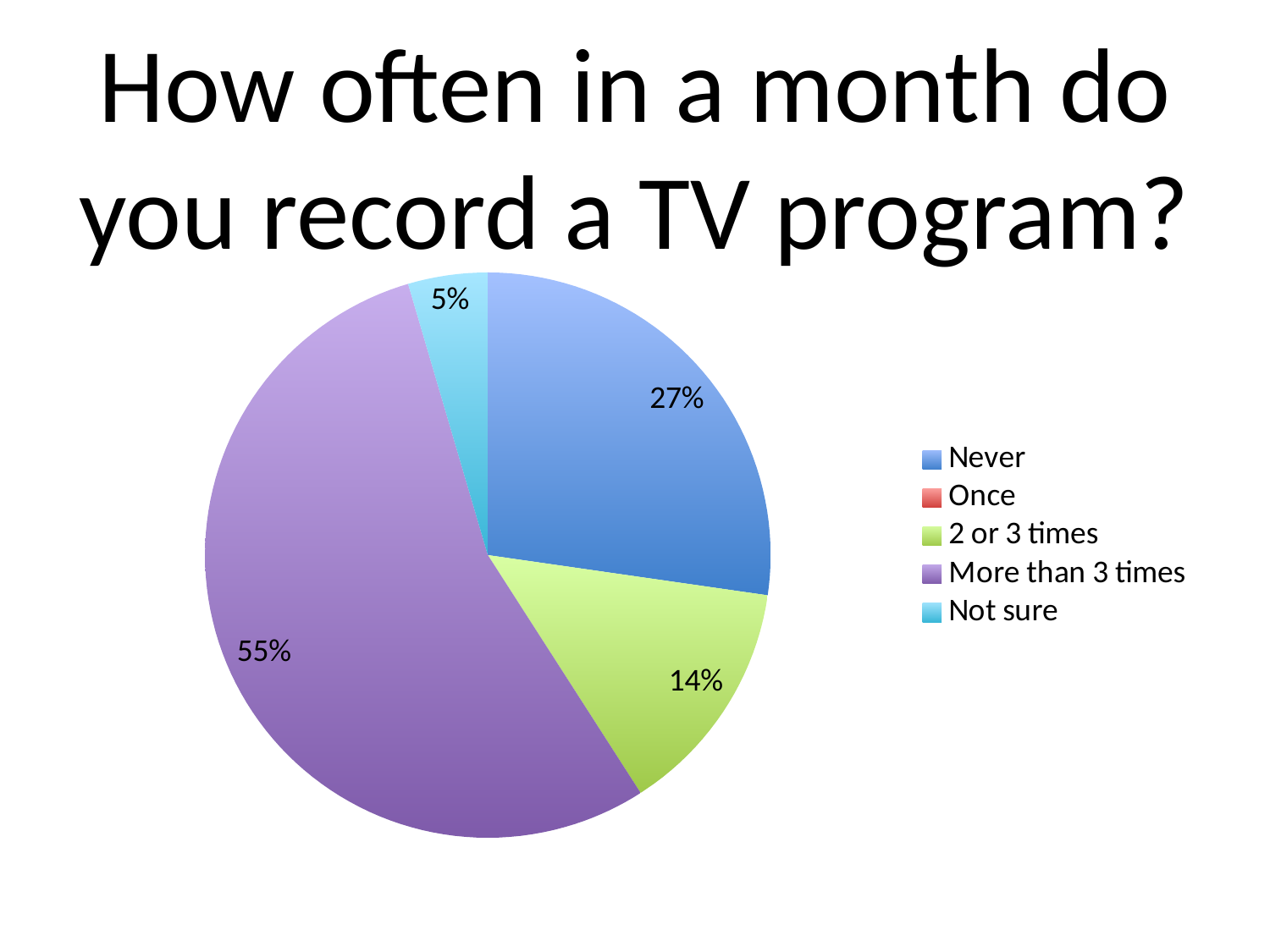
How many percentage points larger is "Never" than "2 or 3 times"? 13 How many percentage points larger is "More than 3 times" than "Never"? 28 What percentage of respondents answered "2 or 3 times"? 14% Which is larger, the share for "Never" or the share for "2 or 3 times"? Never What percentage of respondents answered "More than 3 times"? 55% What is the title of the chart? How often in a month do you record a TV program? What percentage of respondents answered "Never"? 27% Which of the visible slices is the smallest? Not sure How many categories does the legend list? 5 What percentage of respondents answered "Not sure"? 5% Which category has the largest share of the pie? More than 3 times What kind of chart is shown on the slide? Pie chart